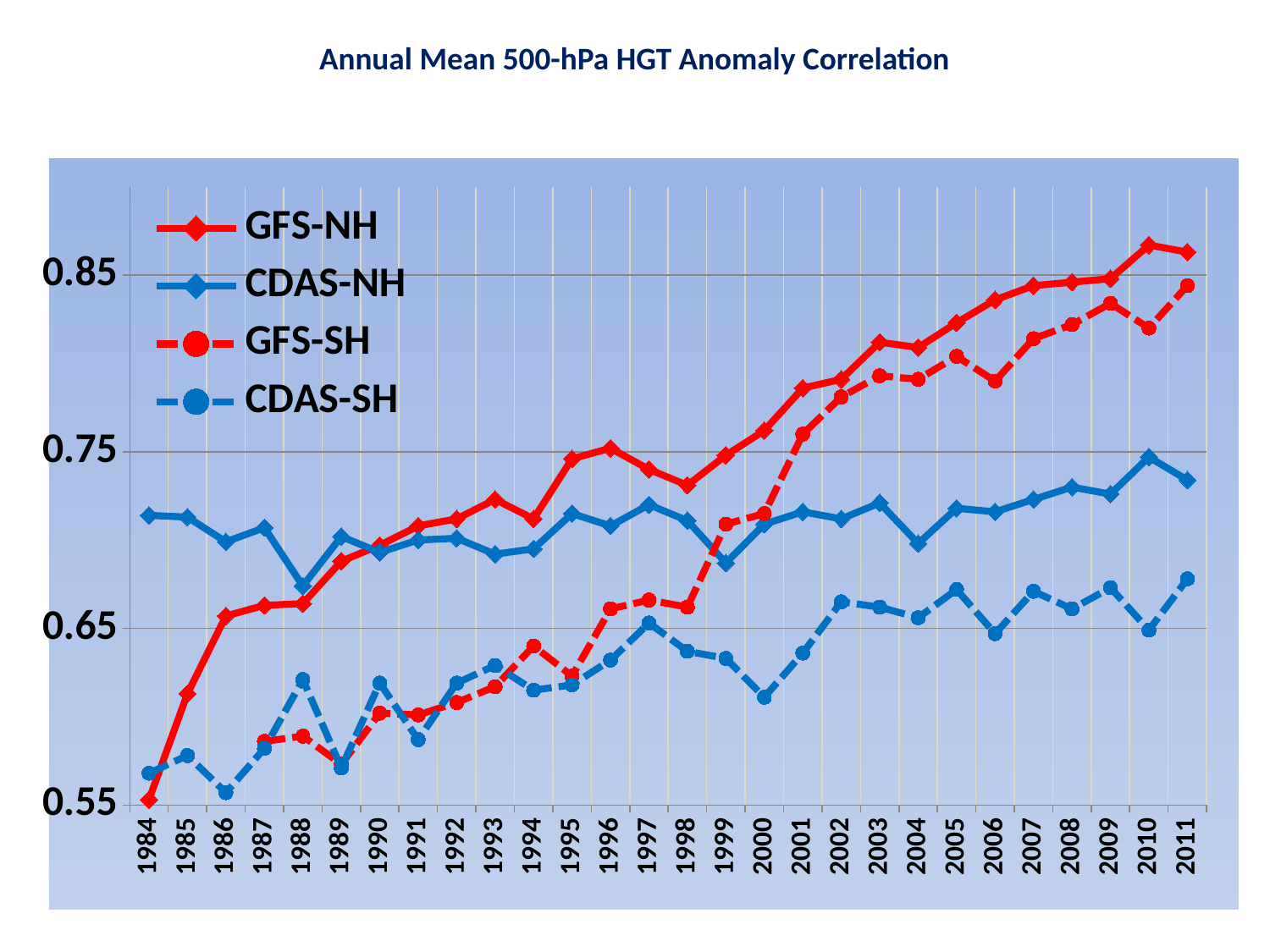
Is the value for GFS-NH in 2003 greater or less than 0.75? greater Does the GFS-NH series generally rise or fall from 1984 to 2011? rise Is the value for CDAS-SH in 1986 greater or less than 0.65? less Is the value for CDAS-NH in 1984 greater or less than 0.65? greater How many series does the legend list? 4 How many years are plotted along the x axis? 28 Which series has the lowest value in 2011? CDAS-SH What kind of chart is shown on the slide? line chart In 1984, which is larger: CDAS-NH or GFS-NH? CDAS-NH What is the title of the chart? Annual Mean 500-hPa HGT Anomaly Correlation In 2011, which is larger: GFS-NH or CDAS-NH? GFS-NH